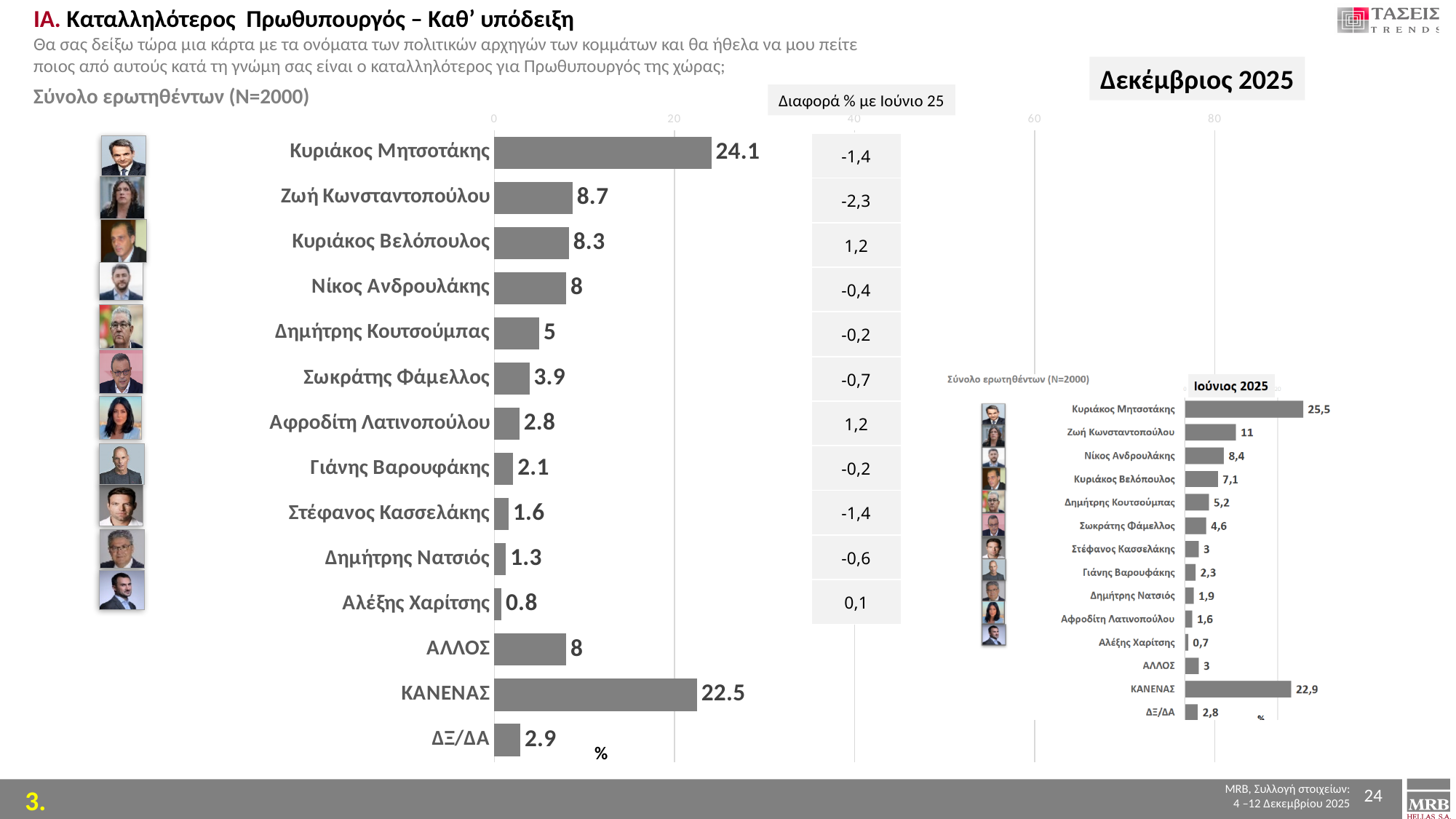
In the Δεκέμβριος 2025 chart, what is the value for ΚΑΝΕΝΑΣ? 22.5 In the Δεκέμβριος 2025 chart, is the value for Κυριάκος Μητσοτάκης greater or less than 20? greater In the Ιούνιος 2025 chart, what is the value for ΚΑΝΕΝΑΣ? 22,9 In the Δεκέμβριος 2025 chart, which category has the highest value? Κυριάκος Μητσοτάκης In the Δεκέμβριος 2025 chart, which is larger: Ζωή Κωνσταντοπούλου or Κυριάκος Βελόπουλος? Ζωή Κωνσταντοπούλου In the Ιούνιος 2025 chart, what is the value for Ζωή Κωνσταντοπούλου? 11 What kind of chart is the Δεκέμβριος 2025 chart? bar chart In the Δεκέμβριος 2025 chart, which category has the lowest value? Αλέξης Χαρίτσης In the Δεκέμβριος 2025 chart, what is the value for Σωκράτης Φάμελλος? 3.9 In the Δεκέμβριος 2025 chart, what is the value for Κυριάκος Μητσοτάκης? 24.1 In the Δεκέμβριος 2025 chart, what is the difference between Κυριάκος Μητσοτάκης and ΚΑΝΕΝΑΣ? 1.6 How many categories are shown in the Δεκέμβριος 2025 chart? 14